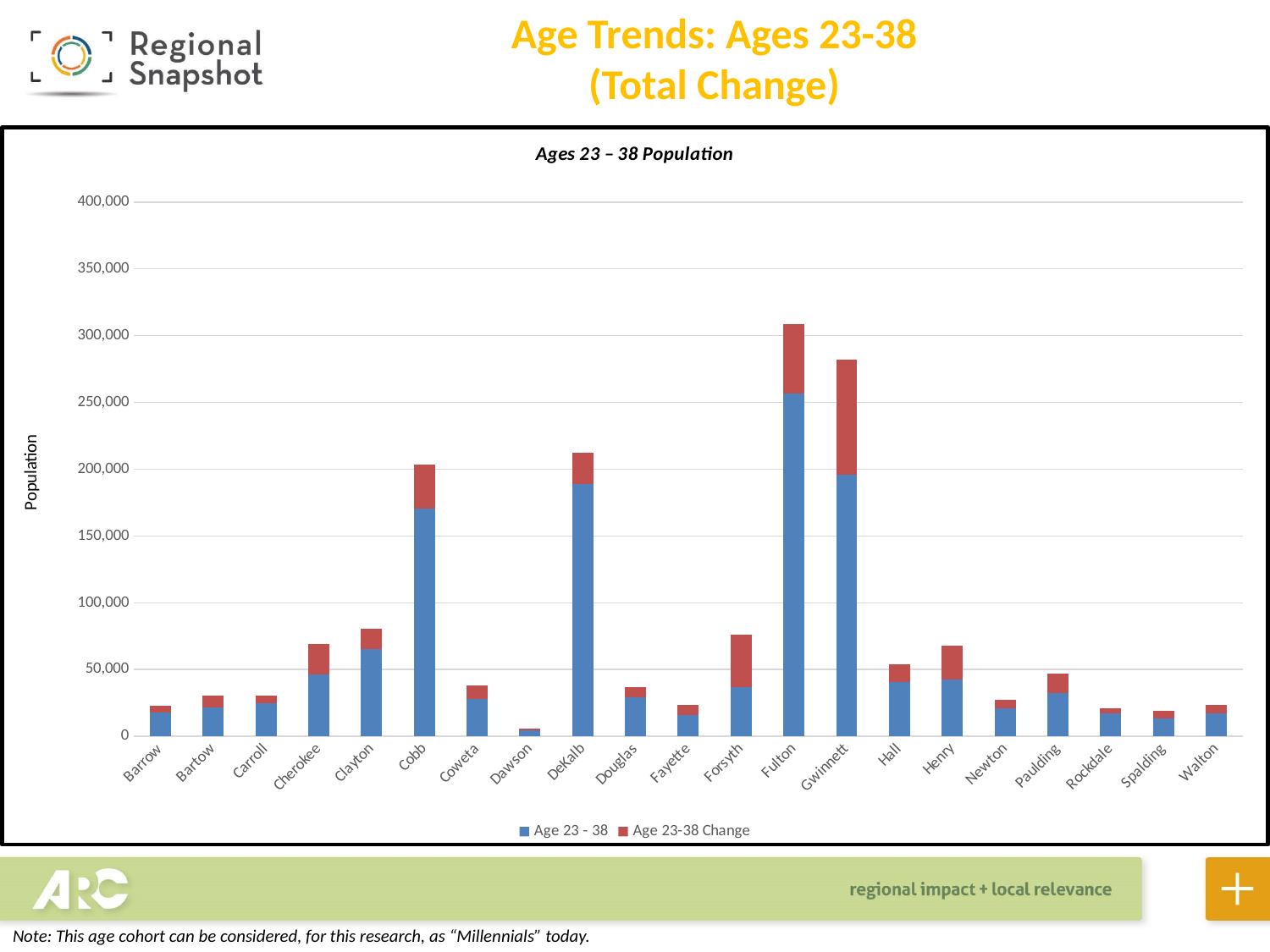
Is the total bar for Dawson greater or less than 50,000? less Is the total bar for Fulton greater or less than 300,000? greater Which county has the shortest total bar in the chart? Dawson How many counties are shown along the x axis of the chart? 21 Which county has the tallest total bar in the chart? Fulton Is the total bar for Clayton greater or less than 50,000? greater Which has the larger total bar, Hall or Henry? Henry How many series does the chart's legend list? 2 What kind of chart is shown on the slide? Stacked bar chart What is the title of the chart? Ages 23 – 38 Population Which has the larger total bar, Fulton or Gwinnett? Fulton